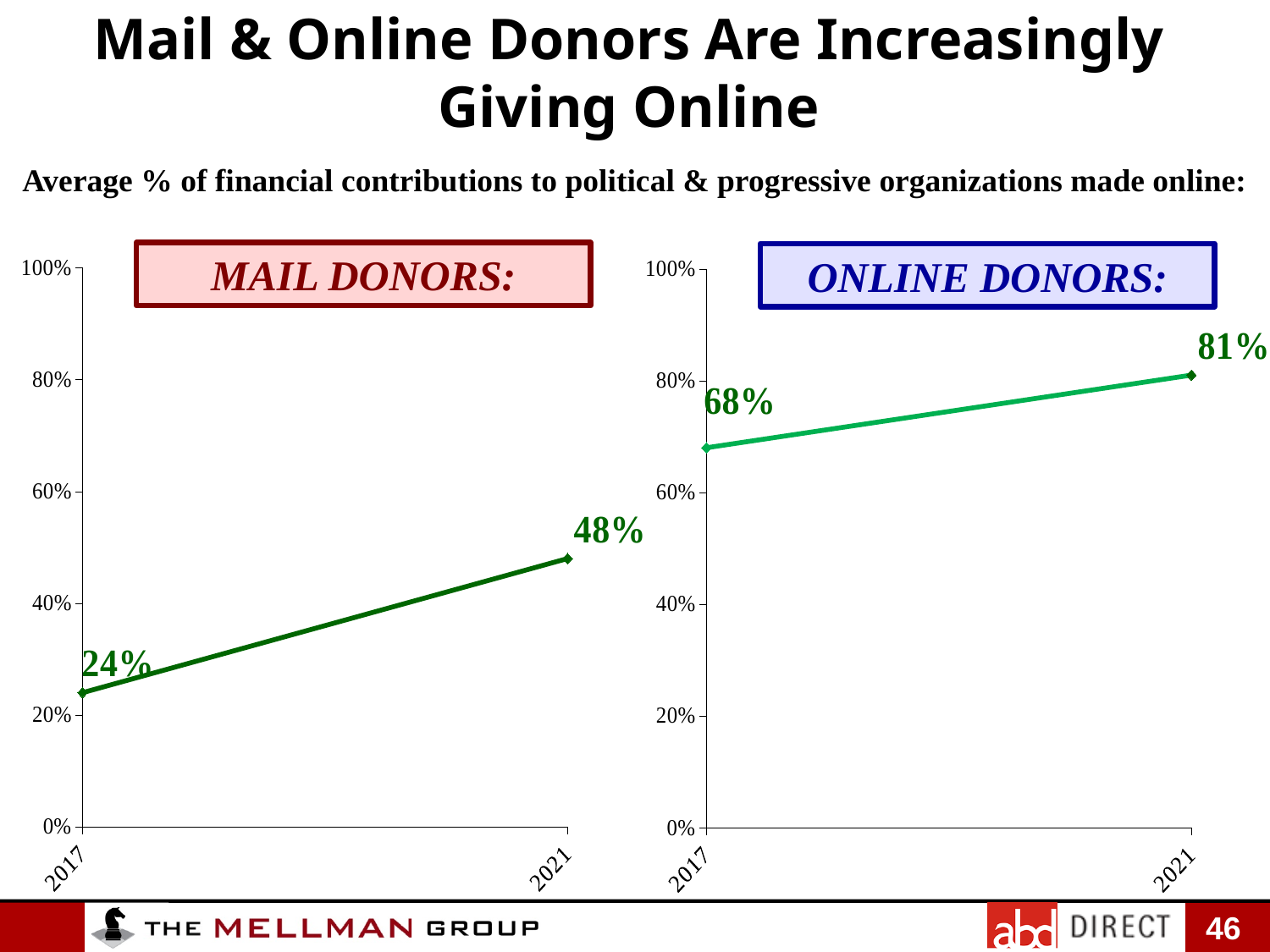
In the Online Donors chart, what is the value for 2021? 81% In the Mail Donors chart, what is the value for 2021? 48% In the Mail Donors chart, what is the value for 2017? 24% In the Online Donors chart, what is the difference between the 2021 and 2017 values? 13% What kind of chart is the Mail Donors chart? line chart Which is larger: the 2021 value in the Mail Donors chart or the 2017 value in the Online Donors chart? the 2017 value in the Online Donors chart In the Online Donors chart, what is the value for 2017? 68% In the Online Donors chart, do the values rise or fall from 2017 to 2021? rise How many data points are plotted in the Online Donors chart? 2 In the Mail Donors chart, do the values rise or fall from 2017 to 2021? rise In the Mail Donors chart, is the value for 2021 greater or less than 40%? greater In the Mail Donors chart, what is the difference between the 2021 and 2017 values? 24%